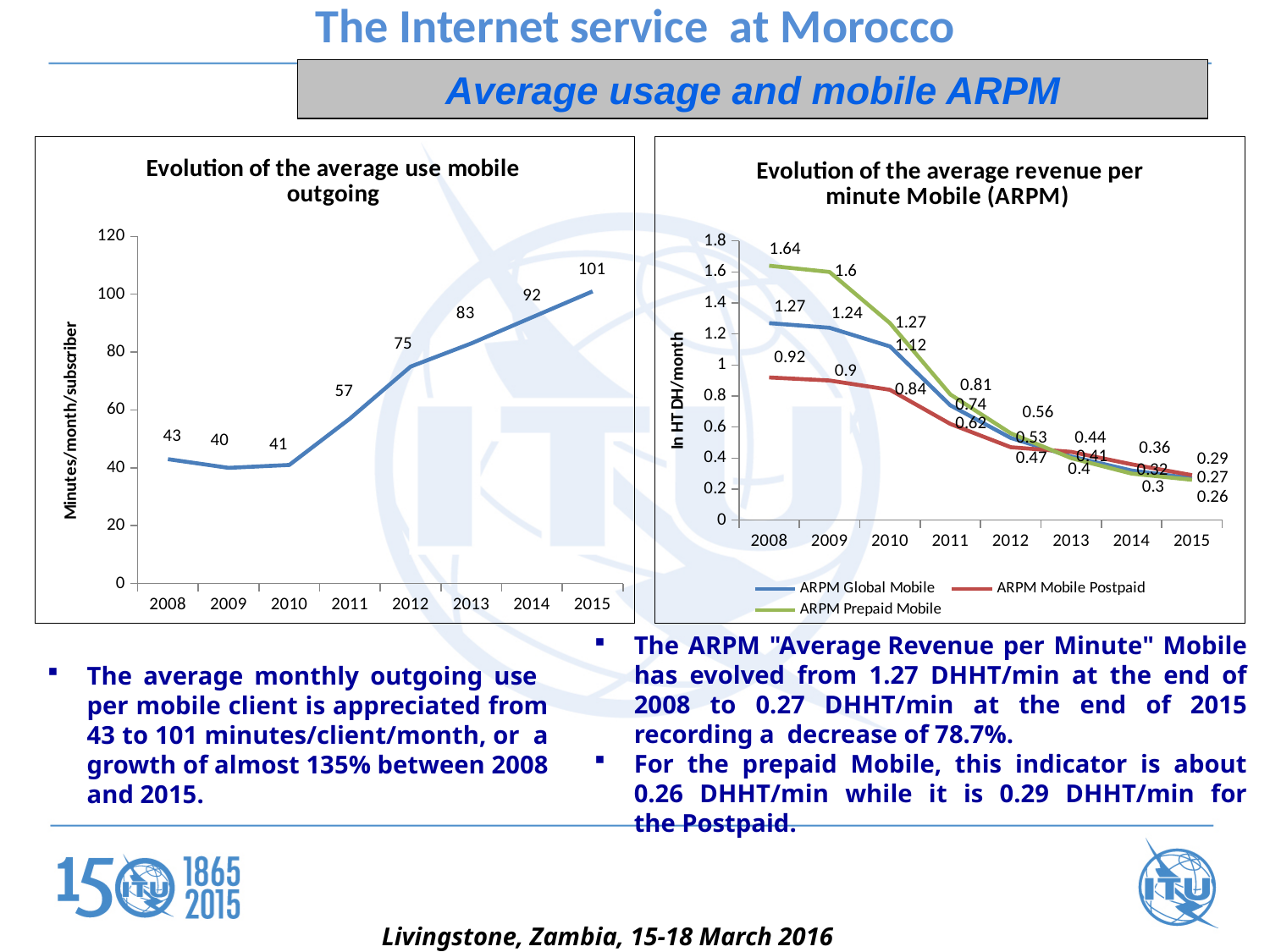
In the chart 'Evolution of the average use mobile outgoing', how many years are plotted on the x axis? 8 In the chart 'Evolution of the average use mobile outgoing', what is the value for 2008? 43 What kind of chart is 'Evolution of the average revenue per minute Mobile (ARPM)'? line chart In the chart 'Evolution of the average revenue per minute Mobile (ARPM)', what is the value of ARPM Prepaid Mobile in 2008? 1.64 In the chart 'Evolution of the average revenue per minute Mobile (ARPM)', is the value of ARPM Global Mobile in 2008 larger or smaller than the value of ARPM Mobile Postpaid in 2008? larger In the chart 'Evolution of the average use mobile outgoing', do the values generally rise or fall from 2010 to 2015? rise In the chart 'Evolution of the average use mobile outgoing', which year has the lowest value? 2009 In the chart 'Evolution of the average use mobile outgoing', what is the value for 2015? 101 In the chart 'Evolution of the average revenue per minute Mobile (ARPM)', what is the value of ARPM Mobile Postpaid in 2015? 0.29 In the chart 'Evolution of the average use mobile outgoing', what is the difference between the 2015 value and the 2008 value? 58 In the chart 'Evolution of the average revenue per minute Mobile (ARPM)', which series has the highest value in 2008? ARPM Prepaid Mobile In the chart 'Evolution of the average revenue per minute Mobile (ARPM)', how many series does the legend list? 3